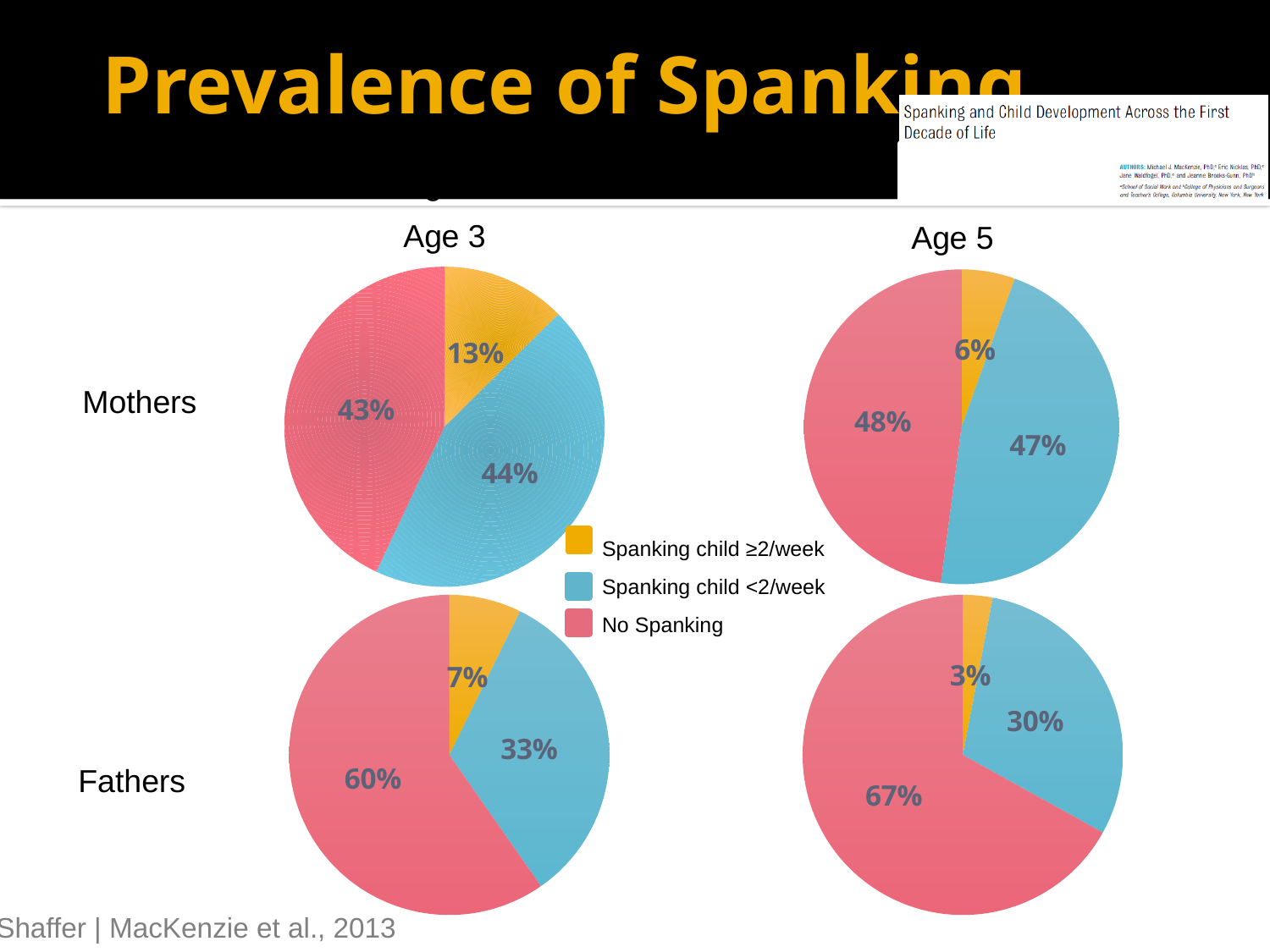
In the Mothers Age 3 pie chart, which category has the smallest slice? Spanking child ≥2/week In the Mothers Age 5 pie chart, what share is labelled for No Spanking? 48% In the Fathers Age 5 pie chart, what share is labelled for Spanking child ≥2/week? 3% Which is larger: the Spanking child <2/week share in the Mothers Age 5 chart or in the Fathers Age 5 chart? Mothers Age 5 In the Mothers Age 3 pie chart, what share is labelled for Spanking child ≥2/week? 13% How many entries does the legend list? 3 How many slices does the Mothers Age 5 pie chart have? 3 What is the difference between the No Spanking share in the Fathers Age 5 chart and the No Spanking share in the Fathers Age 3 chart? 7% In the Fathers Age 3 pie chart, what share is labelled for Spanking child <2/week? 33% What type of chart is used to show the Fathers Age 3 data? Pie chart Which colour represents No Spanking in the legend? Red In the Fathers Age 5 pie chart, which category has the largest slice? No Spanking